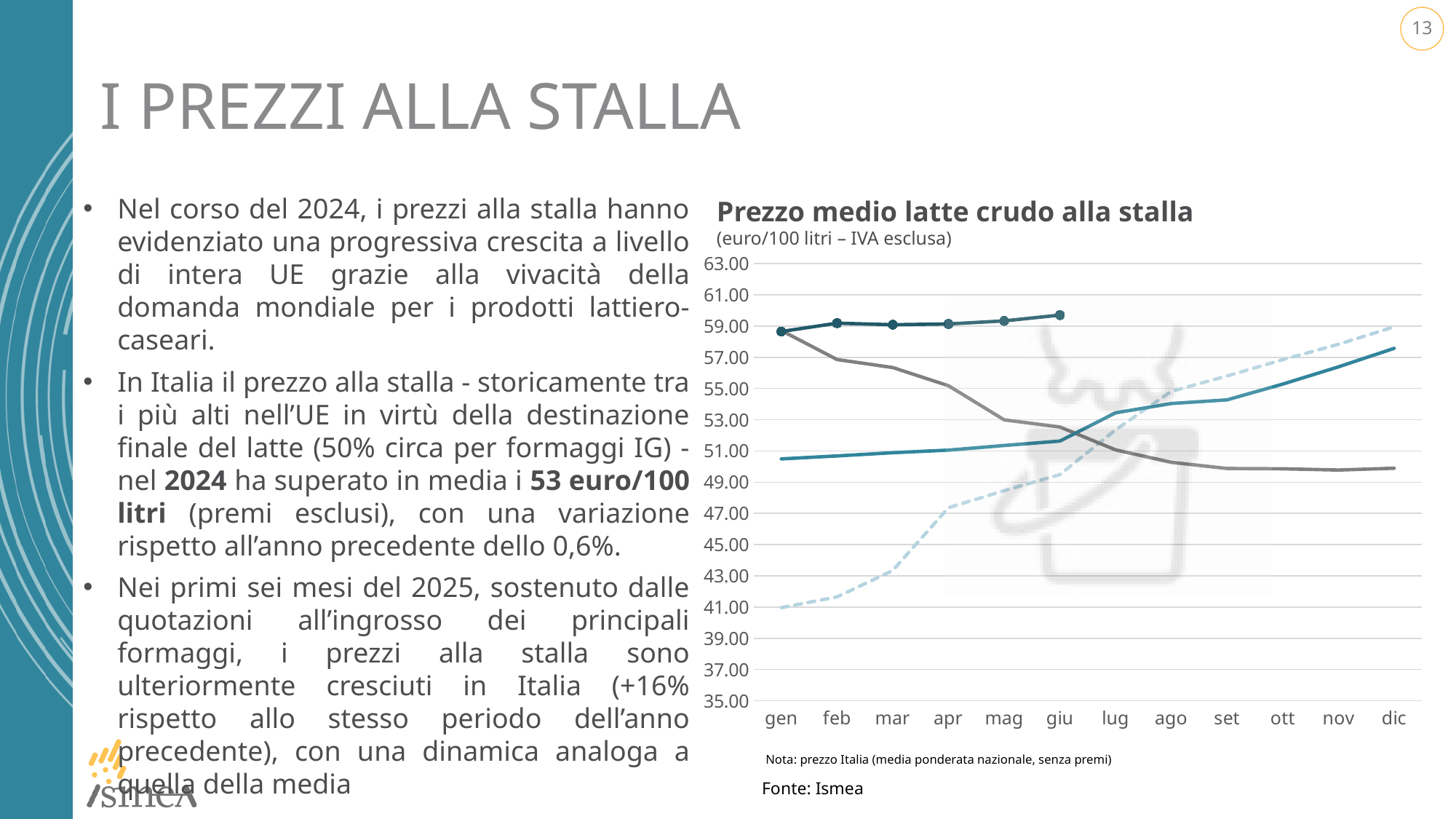
Does the dashed light-blue line rise or fall from gen to dic? rise Is the value of the grey line in dic greater or less than 51.00? less Is the value of the dashed light-blue line in gen greater or less than 43.00? less Is the value of the line with circular markers in giu greater or less than 57.00? greater What unit is given in the chart's subtitle? euro/100 litri – IVA esclusa What kind of chart is shown on the slide? line chart In gen, which is larger: the value of the grey line or the value of the dashed light-blue line? the grey line Does the solid teal line rise or fall from gen to dic? rise What is the title of the chart? Prezzo medio latte crudo alla stalla How many months are shown on the x axis of the chart? 12 Does the grey line rise or fall from gen to dic? fall